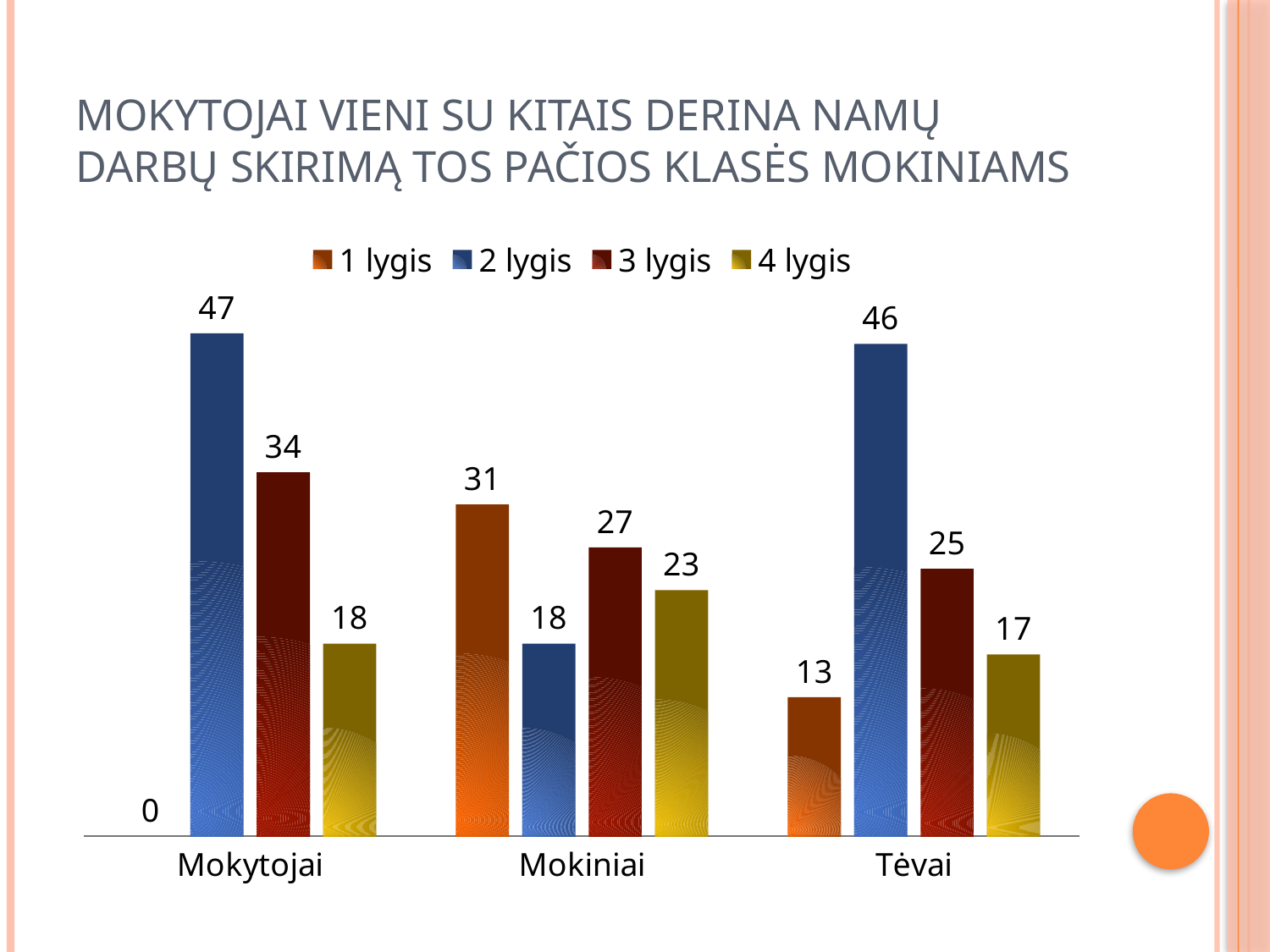
What is the difference between the 2 lygis values for Mokytojai and Mokiniai? 29 What is the value of 2 lygis for Mokytojai? 47 What kind of chart is shown on the slide? Bar chart What is the value of 1 lygis for Mokiniai? 31 Which category has the highest value for 2 lygis? Mokytojai Which is larger: 3 lygis for Mokiniai or 4 lygis for Mokiniai? 3 lygis for Mokiniai What is the value of 4 lygis for Tėvai? 17 Which category has the lowest value for 3 lygis? Tėvai What is the value of 1 lygis for Mokytojai? 0 How many categories are shown on the x axis? 3 What colour are the 2 lygis bars? Blue How many series does the legend list? 4